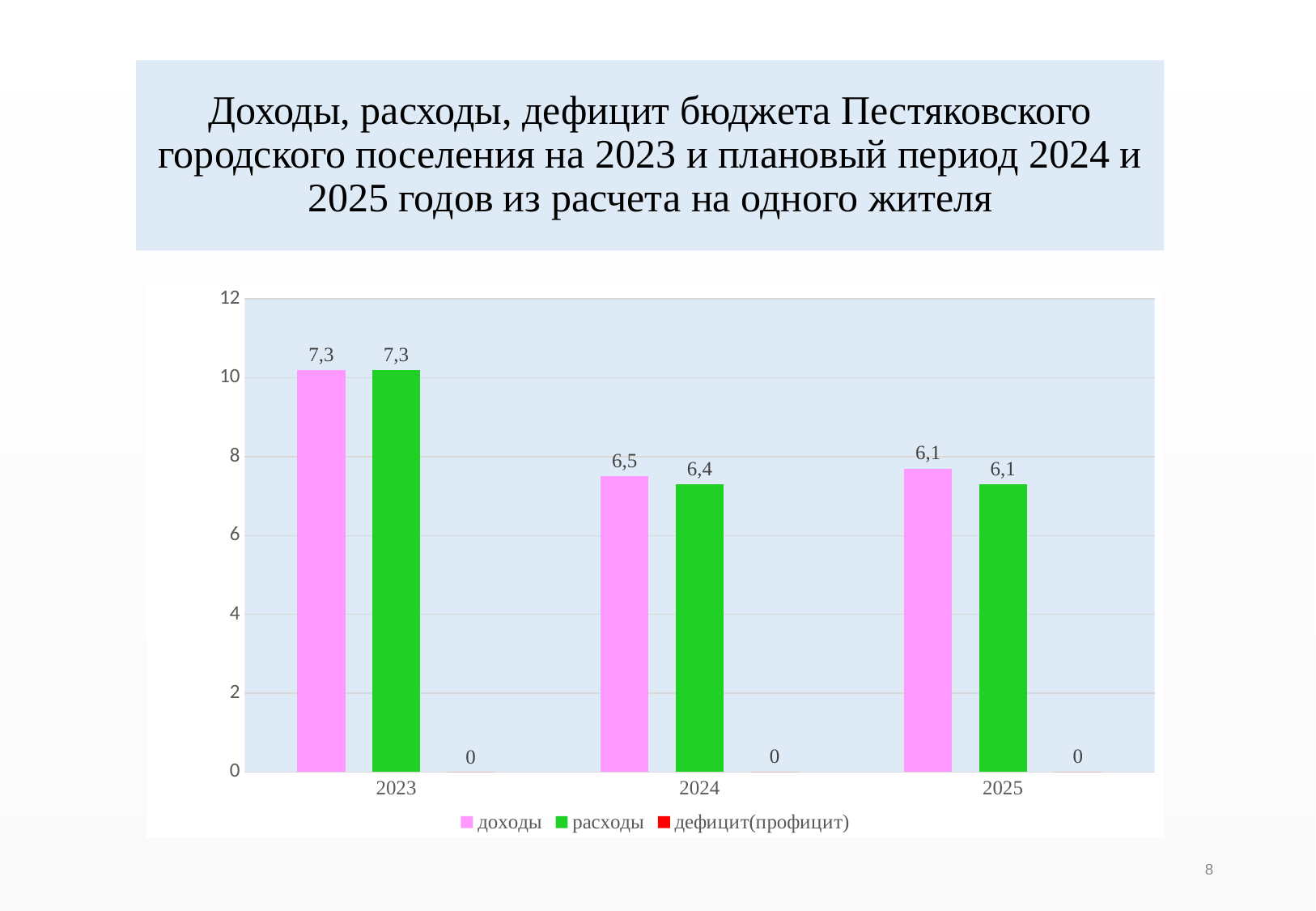
In which year is расходы the lowest? 2025 Which colour represents расходы in the legend? green What is the value of дефицит(профицит) for 2024? 0 How many series does the legend list? 3 Do the values of доходы rise or fall from 2023 to 2025? fall What is the difference between доходы and расходы in 2024? 0,1 How many years are shown on the x axis? 3 What type of chart is shown on the slide? bar chart What is the value of расходы for 2024? 6,4 What is the value of доходы for 2023? 7,3 In which year is доходы the highest? 2023 What is the value of доходы for 2025? 6,1